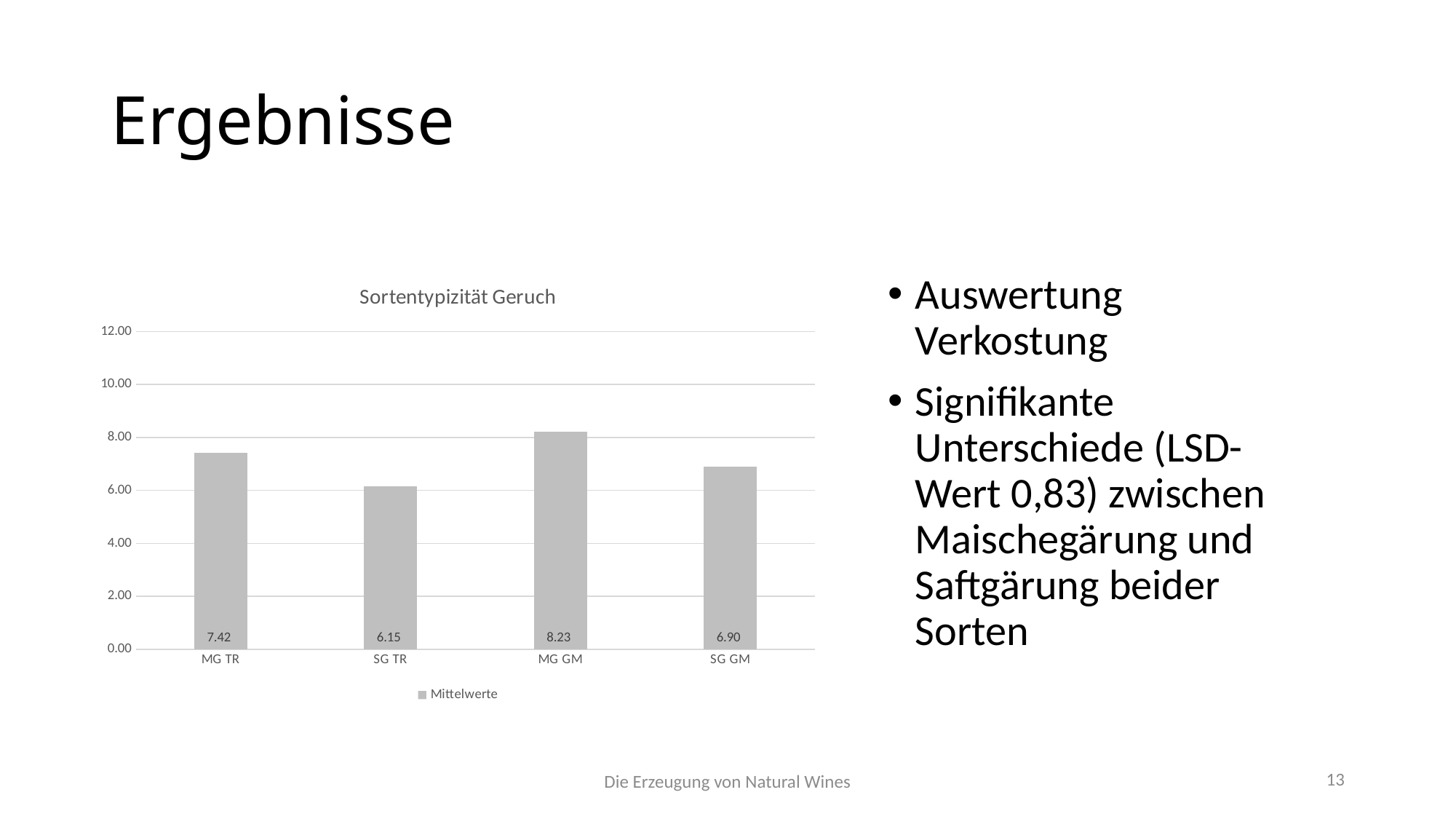
What is the value for MG GM? 8.23 What is the title of the chart? Sortentypizität Geruch What is the value for MG TR? 7.42 Which category has the highest value? MG GM Which is larger, the value for MG TR or the value for SG TR? MG TR Is the value for MG GM greater or less than 8.00? greater What is the value for SG TR? 6.15 How many categories are shown on the x axis? 4 What is the difference between the values for MG GM and SG GM? 1.33 What kind of chart is shown on the slide? Bar chart What is the value for SG GM? 6.90 Which category has the lowest value? SG TR